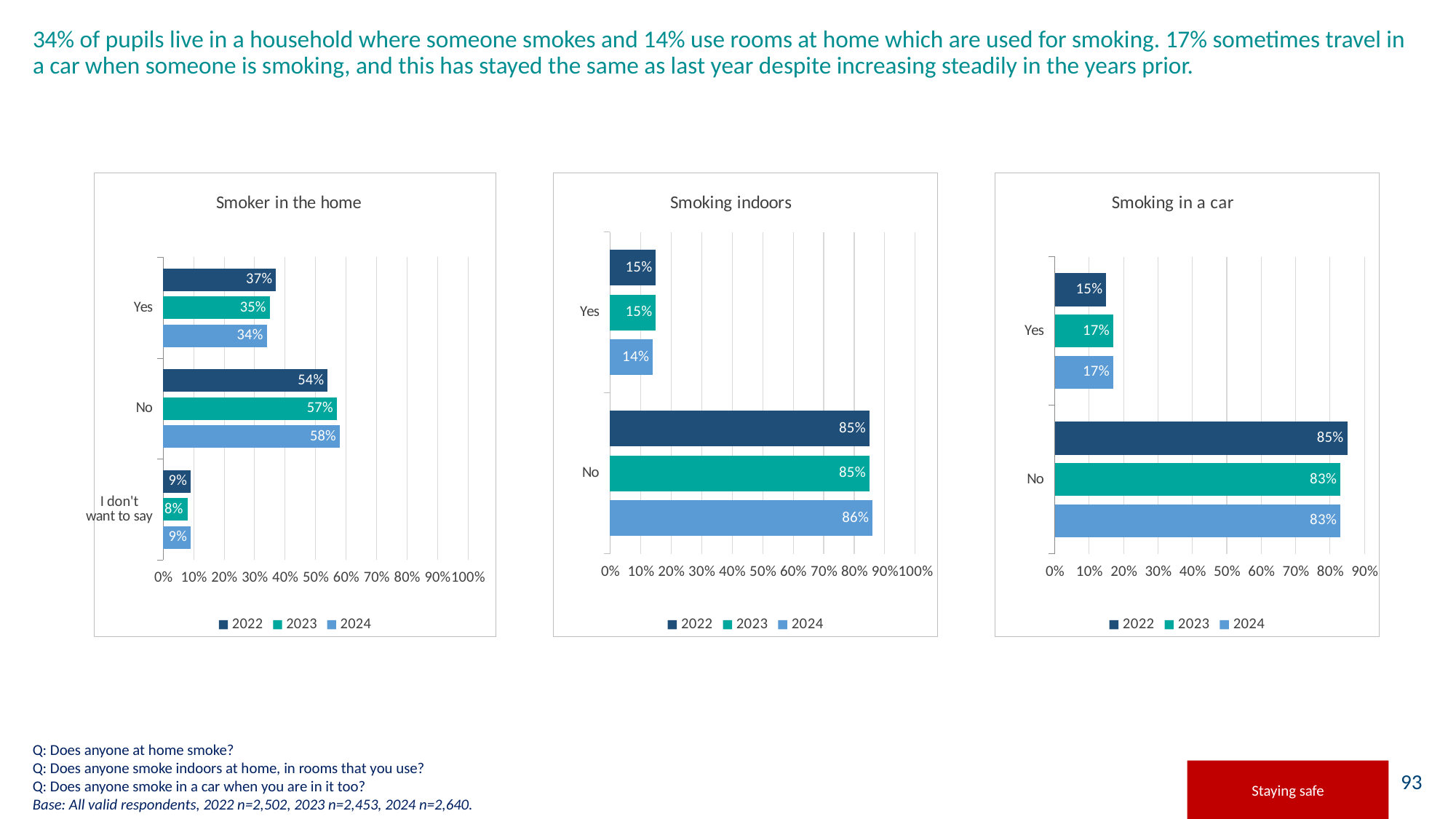
How many series does the legend of the 'Smoking in a car' chart list? 3 In the 'Smoking indoors' chart, what is the value for 'Yes' in 2024? 14% In the 'Smoking in a car' chart, what is the difference between the 2022 and 2024 values for 'Yes'? 2% In the 'Smoker in the home' chart, which category has the highest value in 2024? No In the 'Smoker in the home' chart, what is the value for 'No' in 2022? 54% In the 'Smoking in a car' chart, what is the value for 'No' in 2023? 83% In the 'Smoking indoors' chart, is the 2022 value for 'No' larger or smaller than the 2024 value for 'No'? smaller In the 'Smoker in the home' chart, what is the value for 'I don't want to say' in 2023? 8% How many categories are shown in the 'Smoker in the home' chart? 3 What kind of chart is the 'Smoking indoors' chart? Bar chart In the 'Smoker in the home' chart, what is the value for 'Yes' in 2024? 34% In the 'Smoker in the home' chart, which category has the lowest value in 2022? I don't want to say